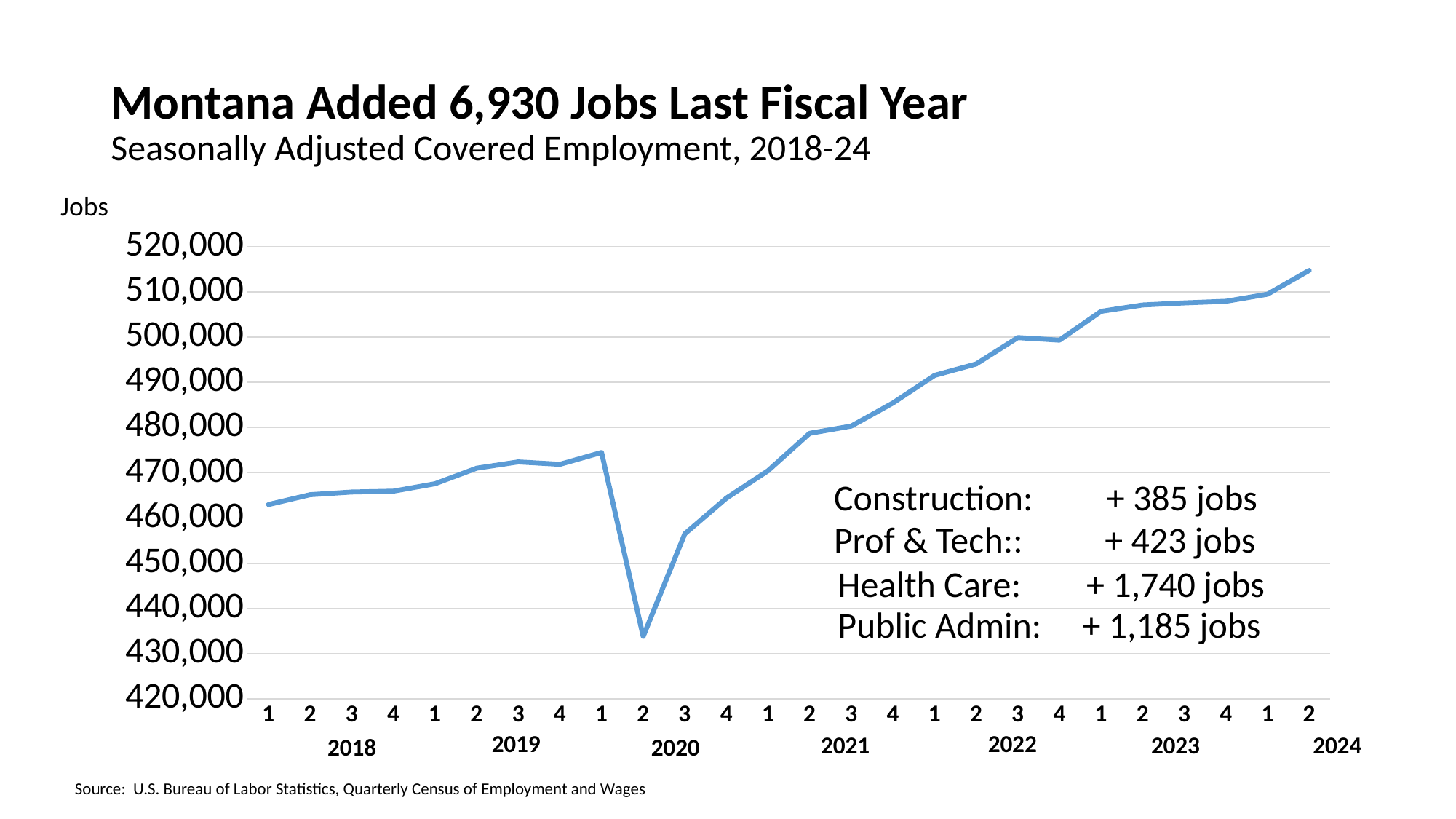
Is the value for 2023 Q1 greater or less than 500,000? greater Which is larger, the value for 2020 Q1 or the value for 2020 Q2? 2020 Q1 Is the value for 2018 Q1 greater or less than 460,000? greater Is the value for 2020 Q2 greater or less than 440,000? less Does employment generally rise or fall from 2020 Q2 to 2024 Q2? rise In which quarter does the employment line reach its lowest point? 2020 Q2 What kind of chart is shown on the slide? line chart How many quarterly data points are plotted on the line? 26 In which quarter does the employment line reach its highest point? 2024 Q2 What is the title of the chart? Montana Added 6,930 Jobs Last Fiscal Year